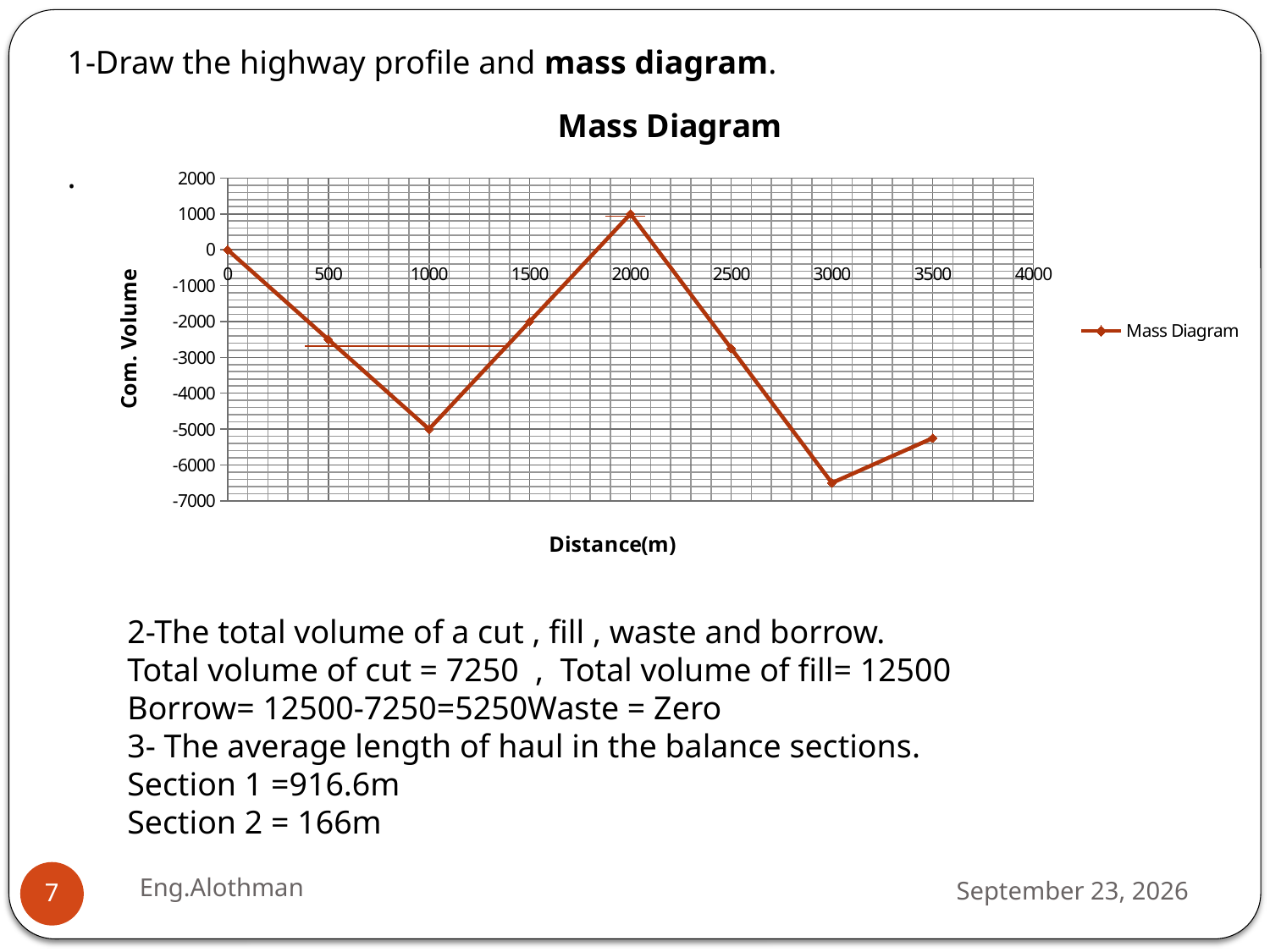
At which distance does the Mass Diagram reach its lowest value? 3000 What is the x-axis title of the chart? Distance(m) What type of chart is shown on the slide? line chart What is the Com. Volume value at a distance of 2000 m? 1000 How many data points are plotted on the Mass Diagram line? 8 Does the Mass Diagram line rise or fall between 1000 m and 2000 m? rise Is the value at a distance of 3000 m greater or less than -6000? less How many series does the legend list? 1 What is the title of the chart? Mass Diagram What is the Com. Volume value at a distance of 1000 m? -5000 At which distance does the Mass Diagram reach its highest value? 2000 What is the Com. Volume value at a distance of 0 m? 0